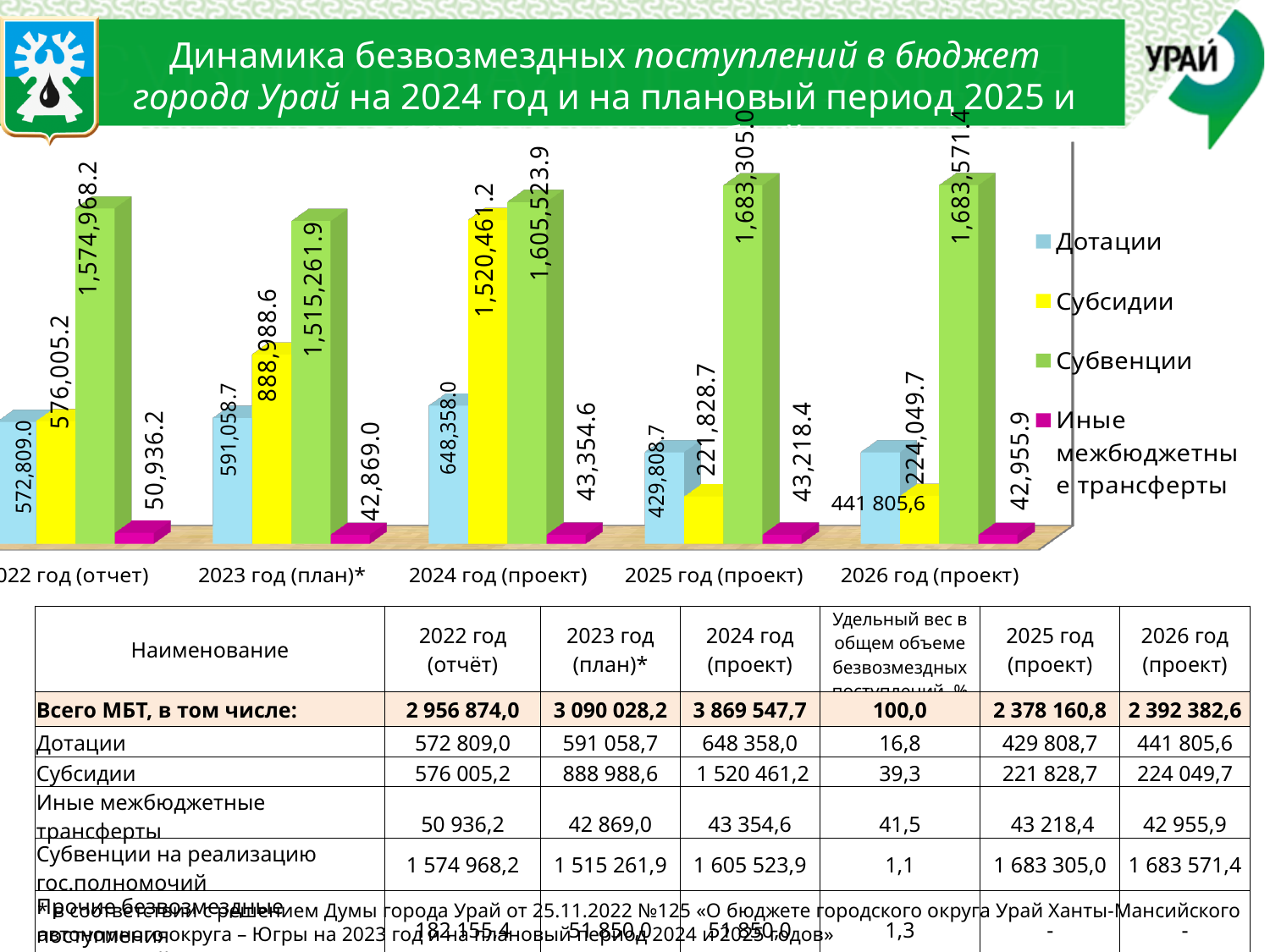
What is the value of Субвенции for 2024 год (проект)? 1,605,523.9 In which year is the Субвенции value highest? 2026 год (проект) Which colour represents Субвенции in the chart legend? green What is the difference between the Субсидии values for 2024 год (проект) and 2025 год (проект)? 1,298,632.5 How many year categories are shown along the x axis of the chart? 5 What type of chart is shown on the slide? bar chart What is the value of Иные межбюджетные трансферты for 2022 год (отчет)? 50,936.2 In which year is the Субсидии value lowest? 2025 год (проект) How many series does the chart legend list? 4 What is the value of Дотации for 2025 год (проект)? 429,808.7 What is the value of Субсидии for 2023 год (план)*? 888,988.6 Which is larger in 2024 год (проект): Дотации or Субсидии? Субсидии